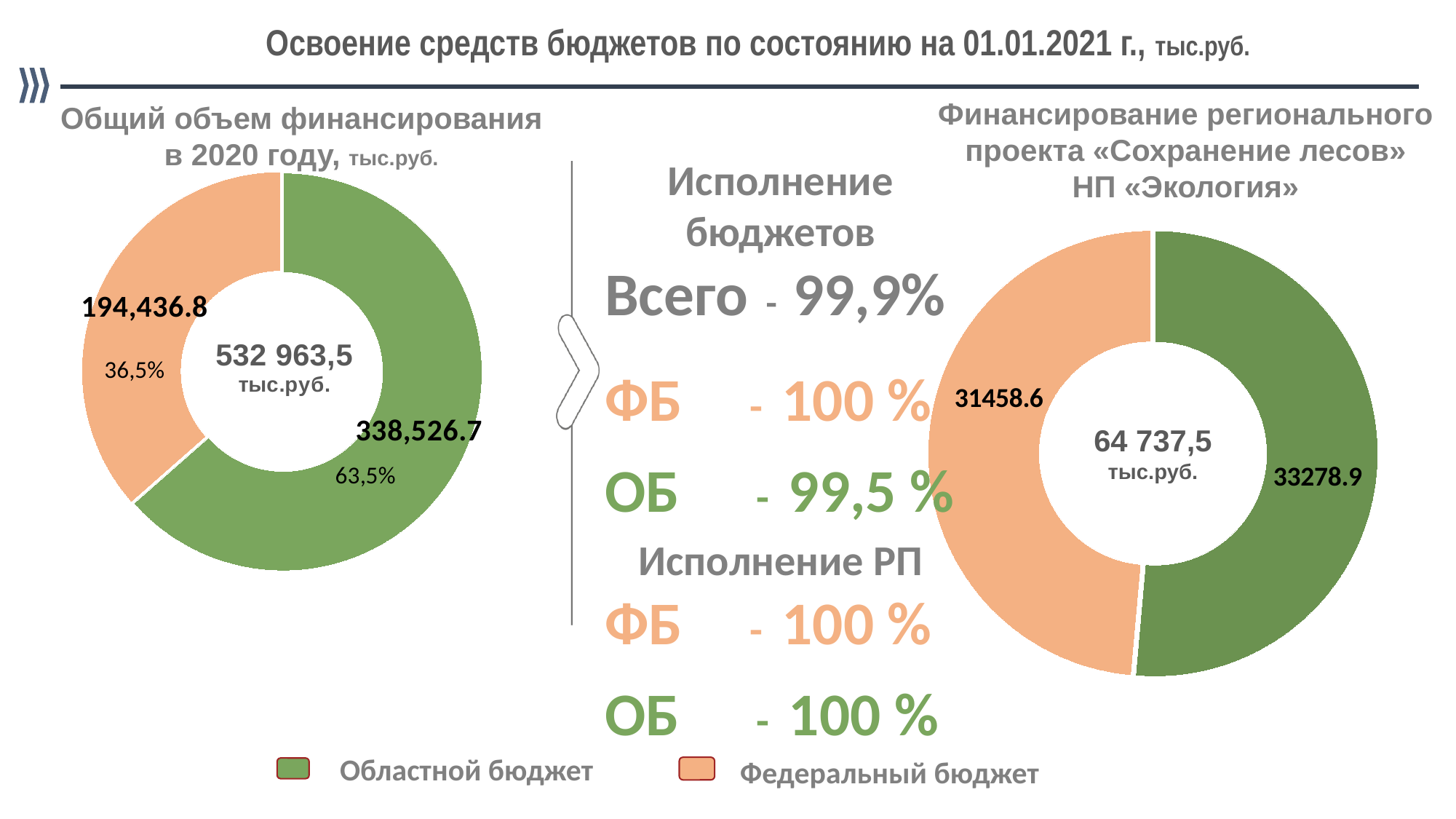
On the left chart (Общий объем финансирования в 2020 году), what share of the total does Областной бюджет represent? 63,5% How many entries does the legend at the bottom of the slide list? 2 On the left chart (Общий объем финансирования в 2020 году), what share of the total does Федеральный бюджет represent? 36,5% On the right chart (Финансирование регионального проекта «Сохранение лесов» НП «Экология»), what total is shown in the centre of the donut? 64 737,5 тыс.руб. On the left chart (Общий объем финансирования в 2020 году), which budget has the larger value? Областной бюджет On the left chart (Общий объем финансирования в 2020 году), what is the value for Областной бюджет? 338,526.7 On the right chart (Финансирование регионального проекта «Сохранение лесов» НП «Экология»), what is the value for Федеральный бюджет? 31458.6 On the right chart (Финансирование регионального проекта «Сохранение лесов» НП «Экология»), what is the value for Областной бюджет? 33278.9 On the right chart (Финансирование регионального проекта «Сохранение лесов» НП «Экология»), what is the difference between the Областной бюджет and Федеральный бюджет values? 1820.3 On the left chart (Общий объем финансирования в 2020 году), what total is shown in the centre of the donut? 532 963,5 тыс.руб. What kind of chart is used on the left side of the slide (Общий объем финансирования в 2020 году)? Pie (donut) chart On the left chart (Общий объем финансирования в 2020 году), what is the value for Федеральный бюджет? 194,436.8